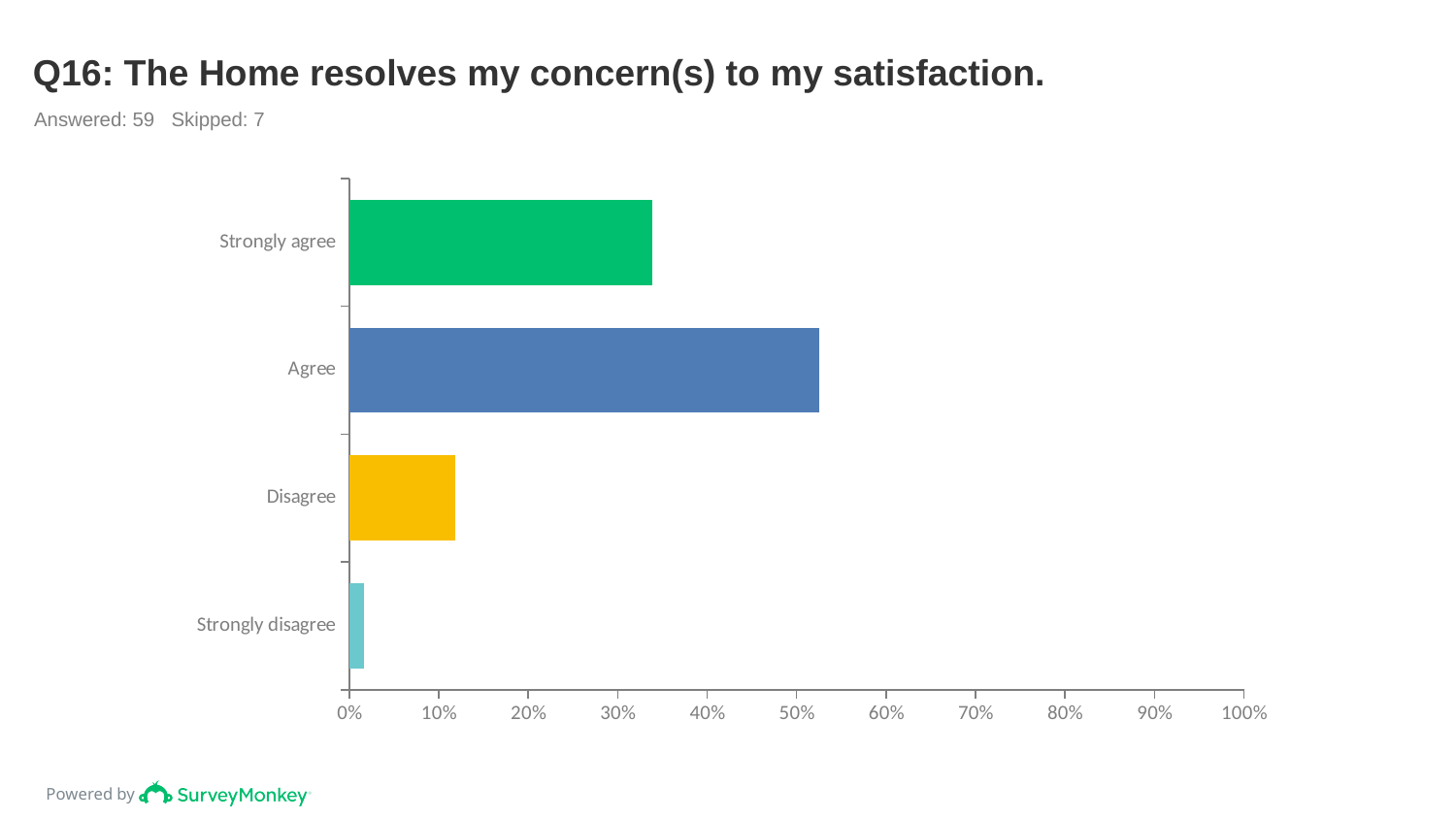
What is the title of the chart? Q16: The Home resolves my concern(s) to my satisfaction. How many respondents answered this question according to the slide? 59 Which is larger, the value for Strongly agree or the value for Agree? Agree Is the value for Strongly disagree greater or less than 10%? less How many response categories are shown in the chart? 4 Is the value for Agree greater or less than 50%? greater Which is larger, the value for Disagree or the value for Strongly disagree? Disagree Is the value for Disagree greater or less than 20%? less Which response category has the highest value? Agree Which response category has the lowest value? Strongly disagree What kind of chart is shown on the slide? bar chart